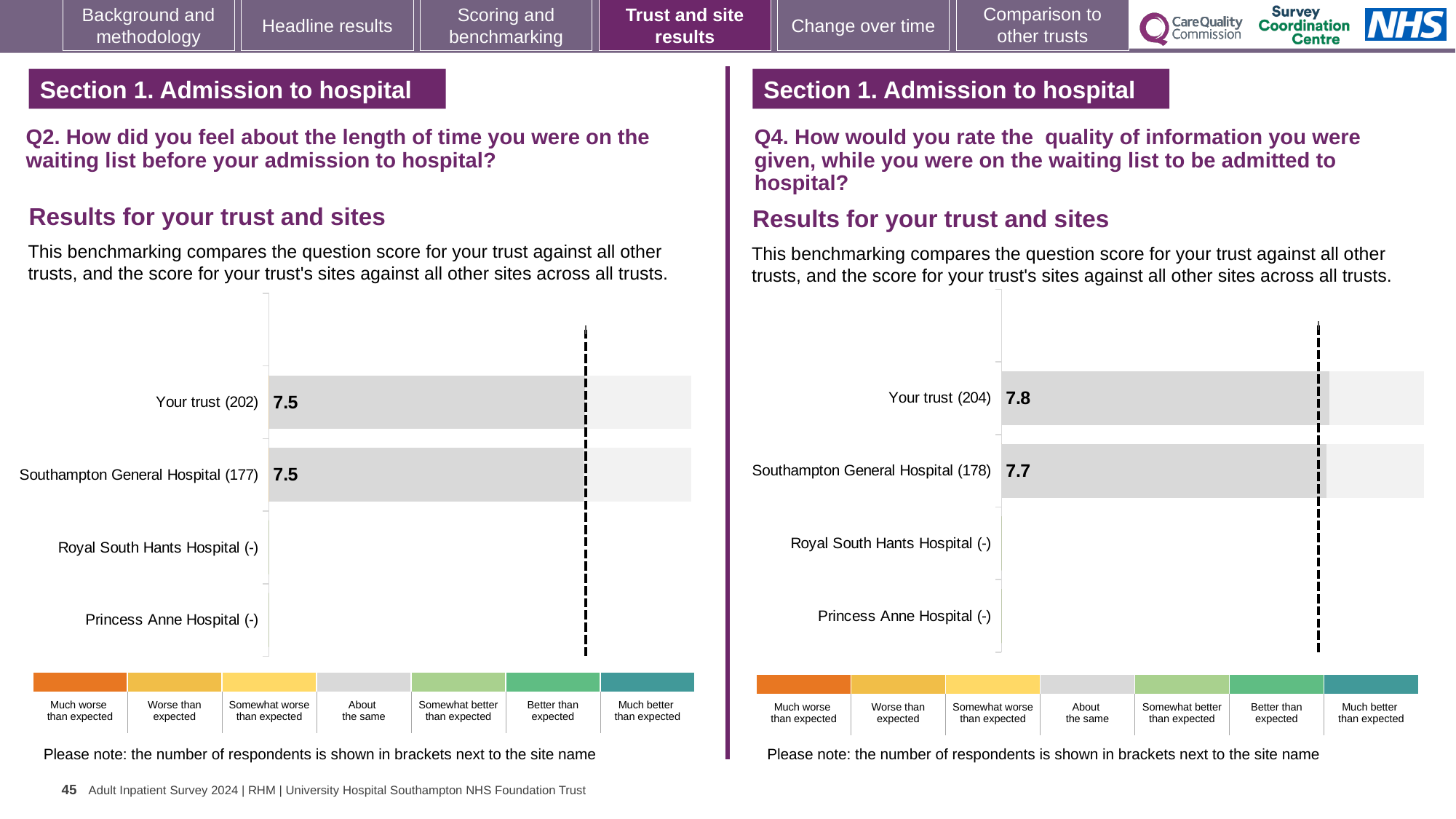
What kind of chart is the left chart (Q2)? Bar chart On the right chart (Q4), how many respondents are shown in brackets for Southampton General Hospital? 178 On the right chart (Q4), what is the difference between the score for Your trust and the score for Southampton General Hospital? 0.1 On the right chart (Q4), what is the score for Your trust? 7.8 How many categories are listed on the left chart (Q2)? 4 On the right chart (Q4), which has the higher score, Your trust or Southampton General Hospital? Your trust On the right chart (Q4), what is the score for Southampton General Hospital? 7.7 On the left chart (Q2), is the score for Your trust equal to the score for Southampton General Hospital? Yes On the left chart (Q2), what is the score for Your trust? 7.5 On the right chart (Q4), which category has the highest score? Your trust On the left chart (Q2), what is the score for Southampton General Hospital? 7.5 On the left chart (Q2), how many respondents are shown in brackets for Your trust? 202